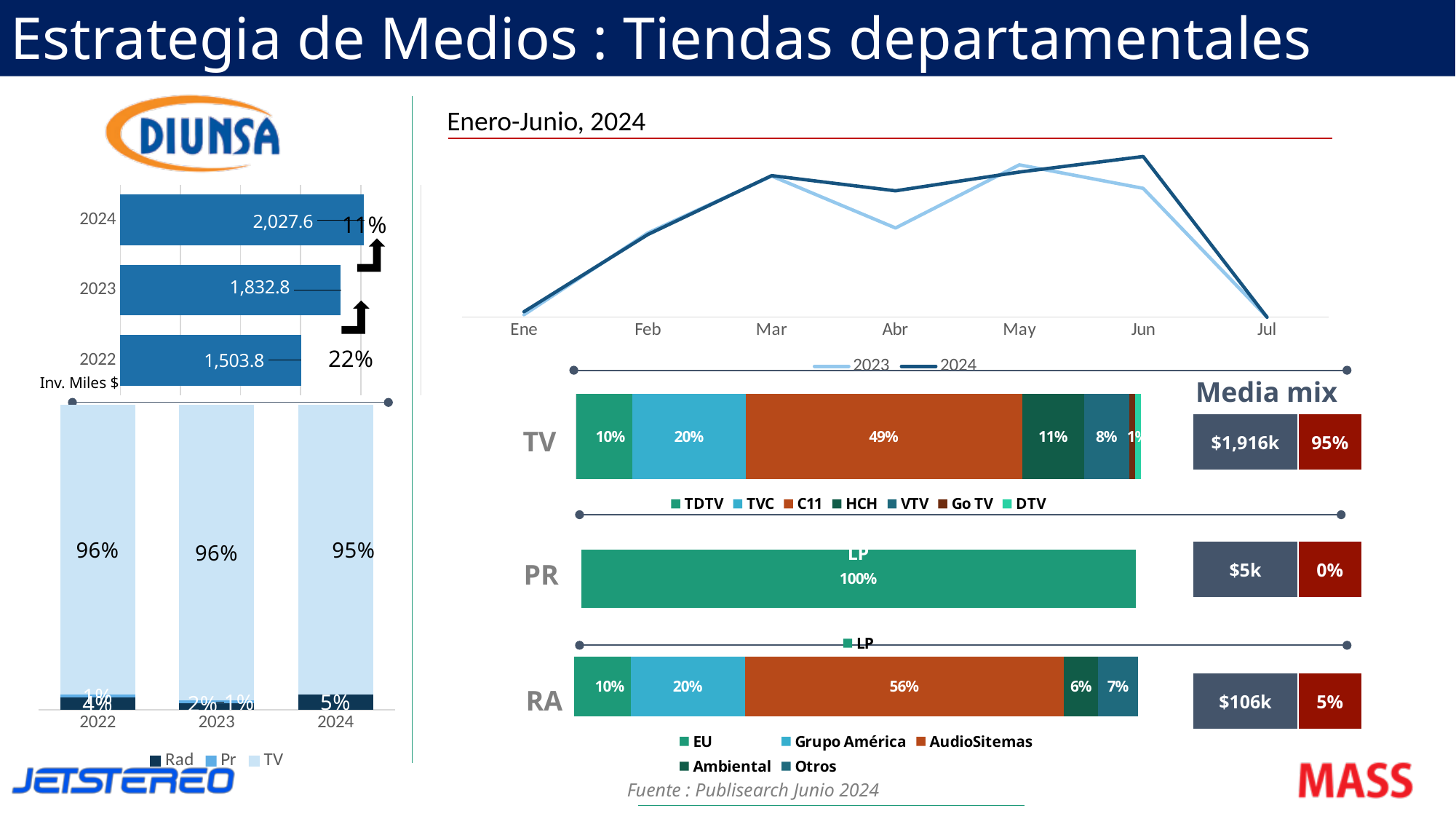
In the stacked bar chart at the bottom left, how many series does the legend list? 3 In the 'Inv. Miles $' bar chart on the left, what is the value for 2022? 1,503.8 In the TV stacked bar on the right, what is the share for C11? 49% In the 'Inv. Miles $' bar chart on the left, which year has the highest value? 2024 In the 'Enero-Junio, 2024' line chart, how many months are shown on the x axis? 7 In the TV stacked bar on the right, which channel has the largest share? C11 In the 'Inv. Miles $' bar chart on the left, what is the difference between the 2024 and 2023 values? 194.8 In the 'Enero-Junio, 2024' line chart, do the values rise or fall from Jun to Jul? fall What kind of chart is the 'Enero-Junio, 2024' chart at the top right? line chart In the RA stacked bar on the right, what is the share for AudioSitemas? 56% In the stacked bar chart at the bottom left (Rad, Pr, TV), what is the TV share for 2024? 95% In the 'Inv. Miles $' bar chart on the left, what is the value for 2024? 2,027.6